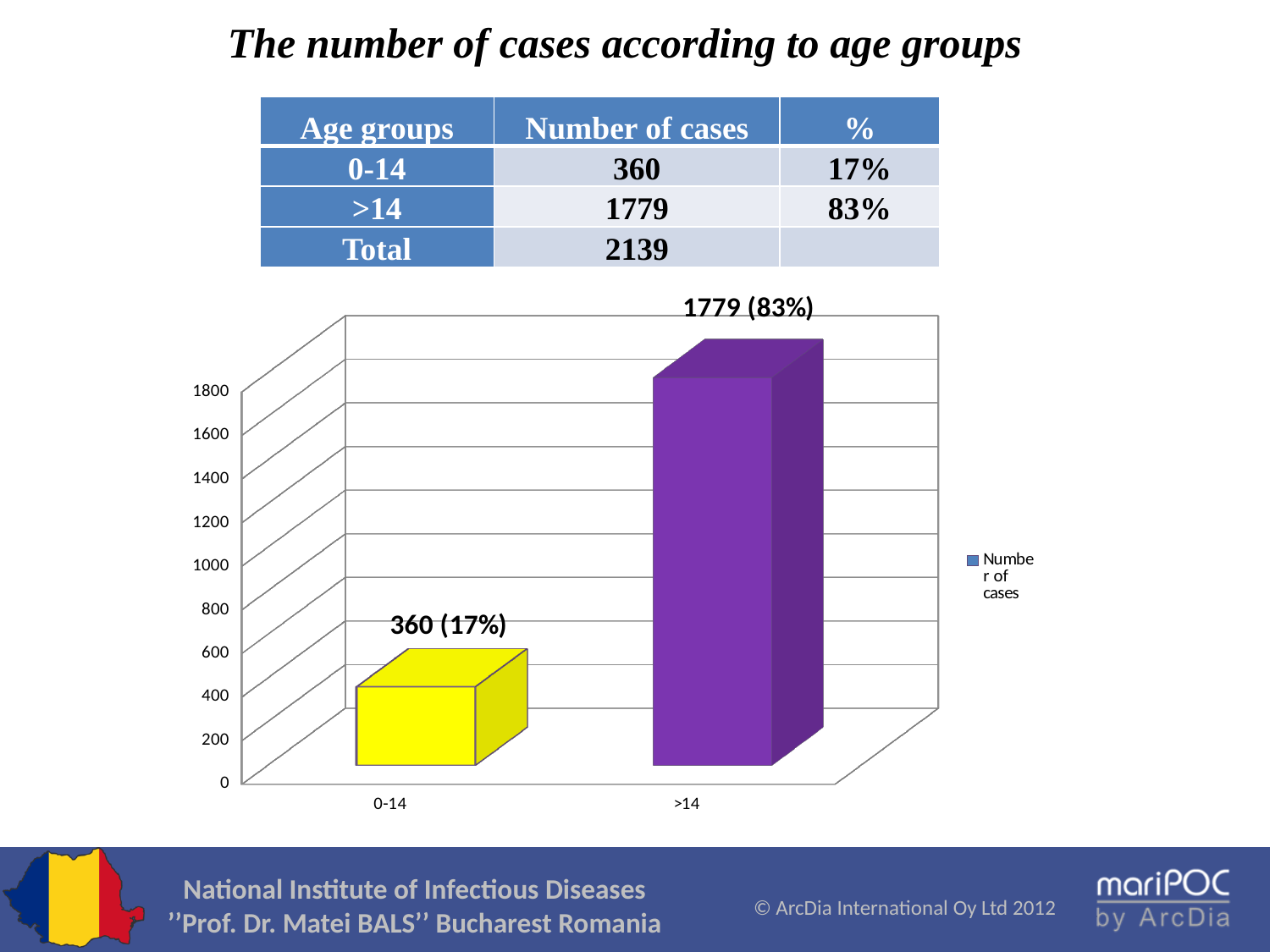
Which age group has more cases, 0-14 or >14? >14 Which age group has the lowest number of cases? 0-14 How many age group categories are shown on the chart? 2 Which age group has the highest number of cases? >14 What is the difference in the number of cases between the >14 and 0-14 age groups? 1419 How many series does the chart legend list? 1 Is the value for the >14 age group greater or less than 1600? greater What is the number of cases for the 0-14 age group? 360 Is the value for the 0-14 age group greater or less than 400? less What kind of chart is shown on the slide? Bar chart What is the number of cases for the >14 age group? 1779 What percentage is shown in the data label for the >14 age group? 83%